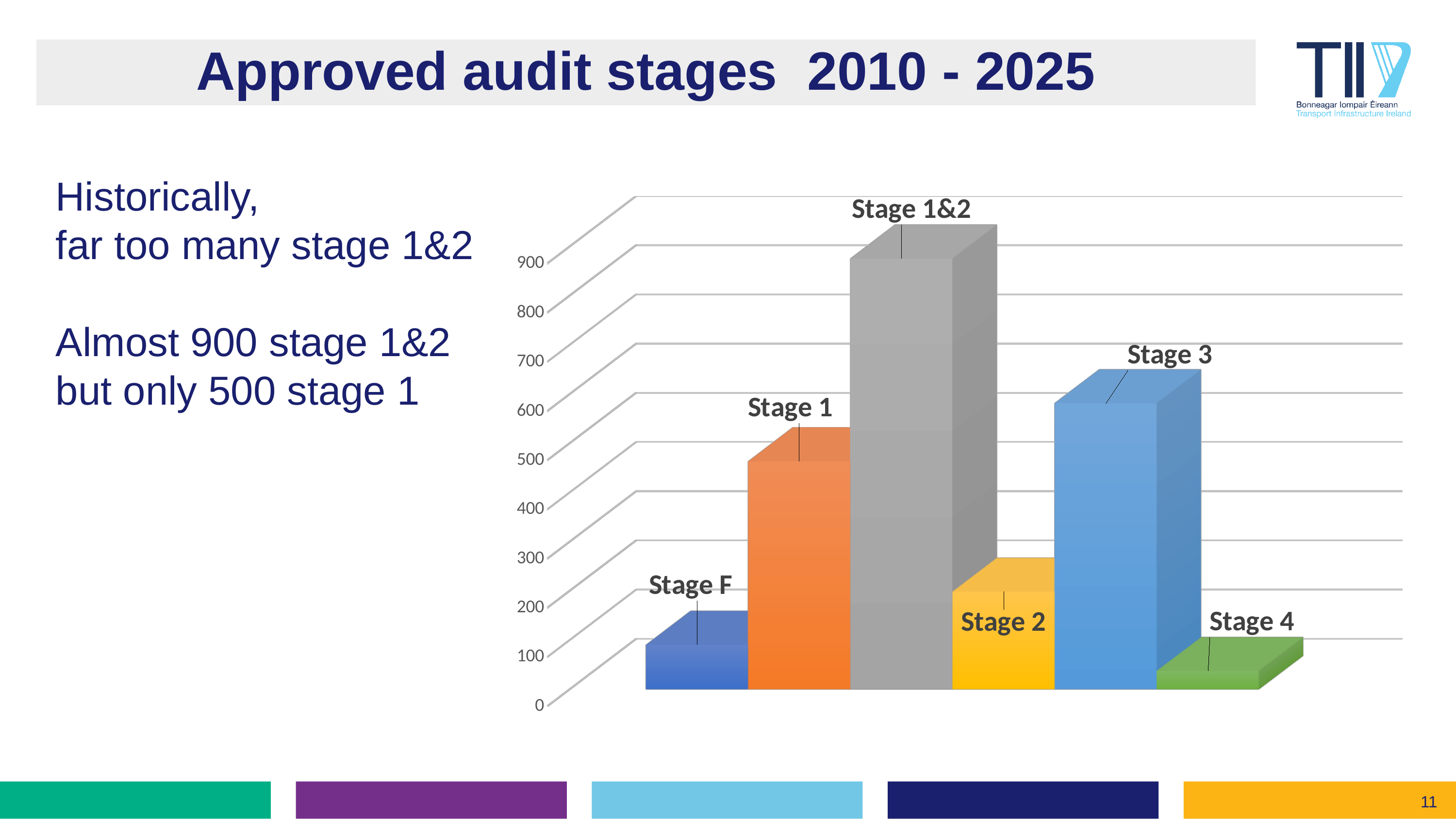
What is the title of the slide containing the chart? Approved audit stages 2010 - 2025 Is the value for Stage 3 greater or less than 500? greater Which is larger, the value for Stage 1 or the value for Stage 3? Stage 3 What colour is the bar for Stage 1&2? grey Is the value for Stage 1&2 greater or less than 800? greater What kind of chart is shown on the slide? bar chart Is the value for Stage F greater or less than 300? less Which stage has the highest bar in the chart? Stage 1&2 Which stage has the lowest bar in the chart? Stage 4 Which is larger, the value for Stage F or the value for Stage 2? Stage 2 How many stage categories are plotted in the chart? 6